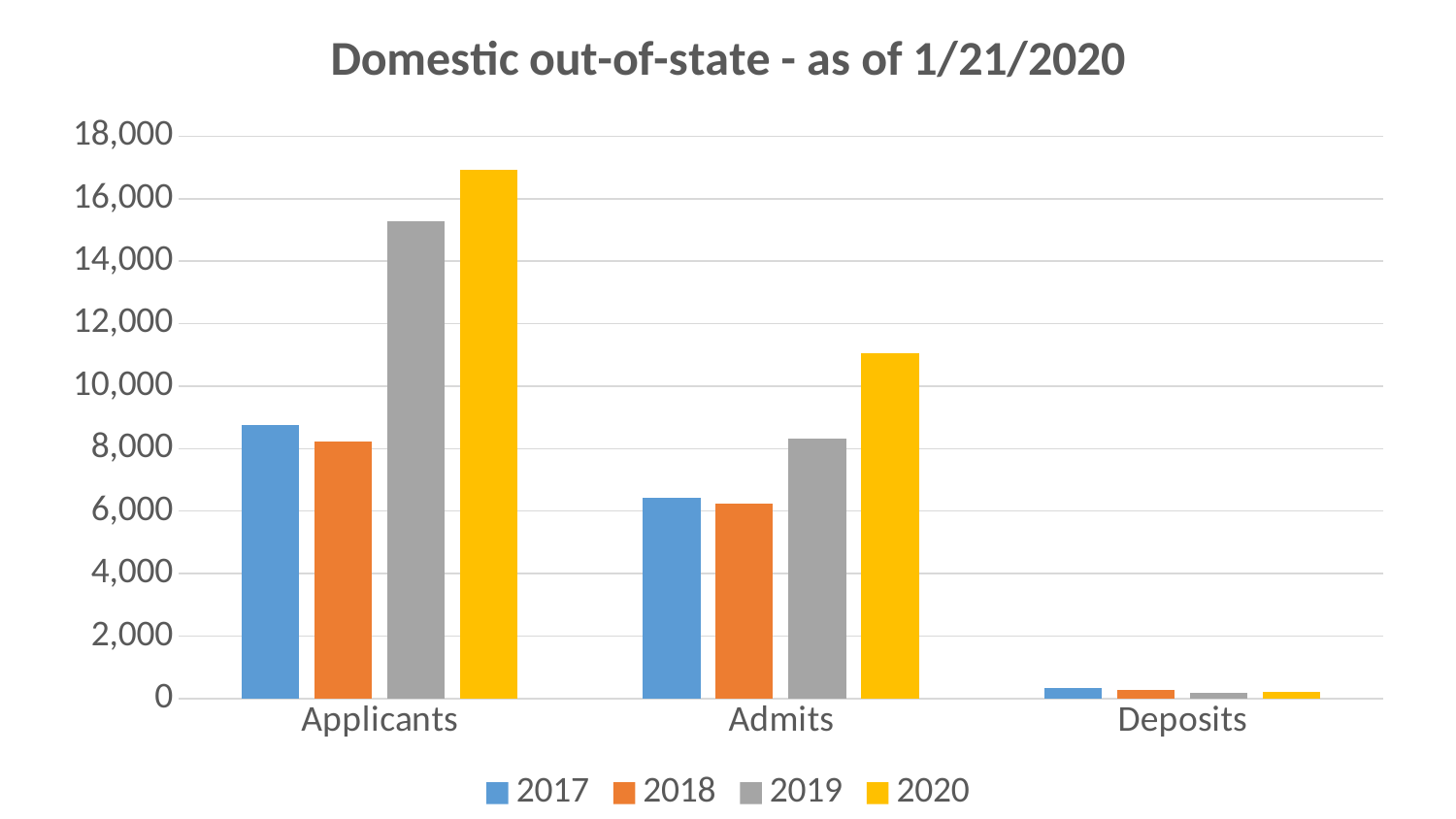
Which category has the lowest values across all years? Deposits How many categories are shown on the x axis? 3 What is the title of the chart? Domestic out-of-state - as of 1/21/2020 Which is larger for Admits: the 2020 value or the 2019 value? 2020 Which is larger for Applicants: the 2019 value or the 2018 value? 2019 Which year has the highest number of Applicants? 2020 What type of chart is shown on the slide? bar chart Which year has the highest number of Admits? 2020 Is the value for Applicants in 2017 greater or less than 10,000? less Is the value for Admits in 2020 greater or less than 10,000? greater Is the value for Applicants in 2020 greater or less than 16,000? greater How many series does the legend list? 4